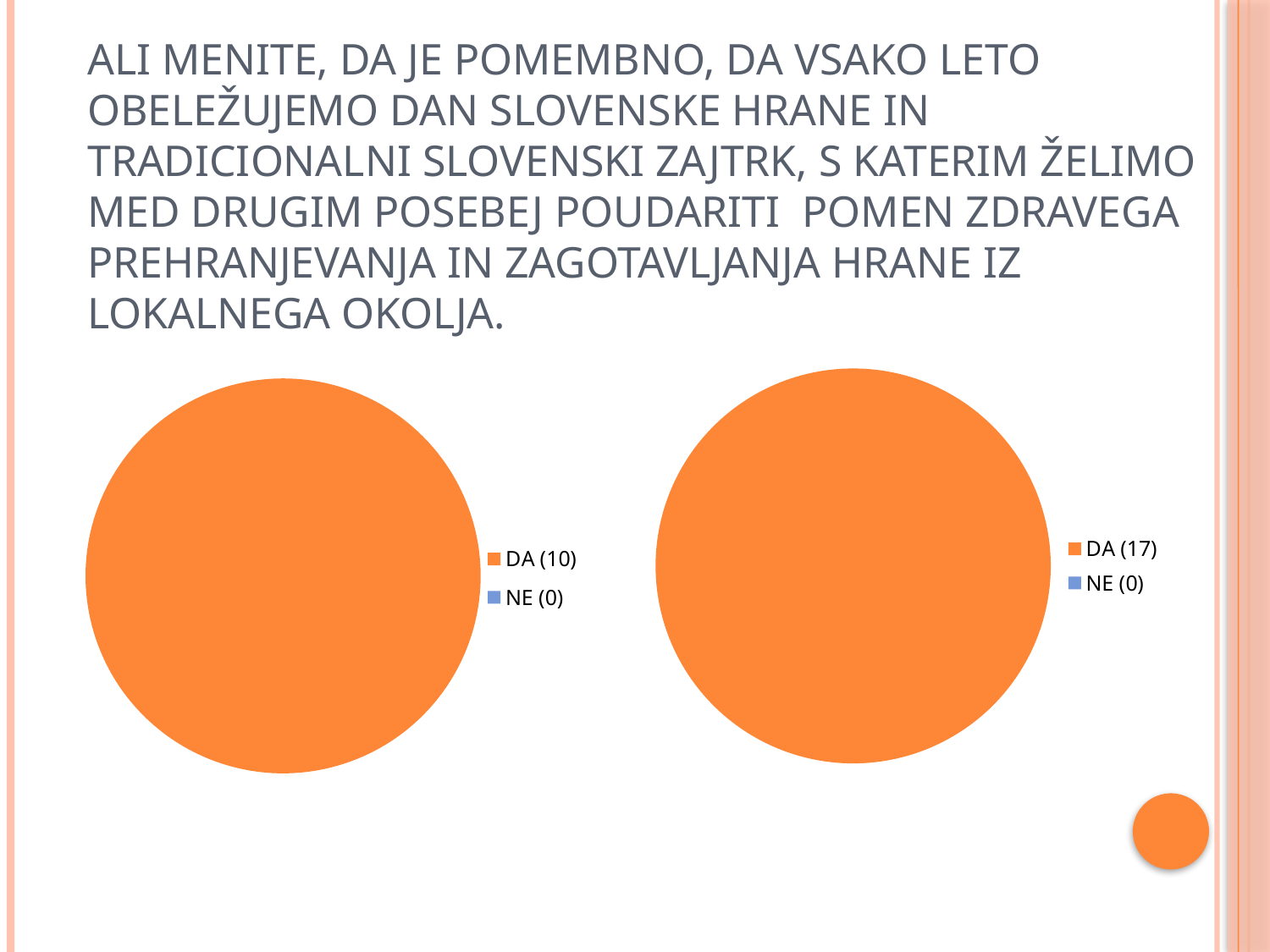
In the right chart, which category has the largest share of the pie? DA (17) In the left chart, how many responses does the legend show for NE? 0 What colour is the DA slice in both pie charts? orange In the left chart, how many responses does the legend show for DA? 10 How many categories does the legend of the left chart list? 2 In the right chart, how many responses does the legend show for NE? 0 In the right chart, how many responses does the legend show for DA? 17 What is the difference between the DA count in the right chart and the DA count in the left chart? 7 What kind of chart is the right chart on the slide? pie chart What share of the right chart's pie does DA take up? 100% In the left chart, which category has the smallest share of the pie? NE (0) What kind of chart is the left chart on the slide? pie chart